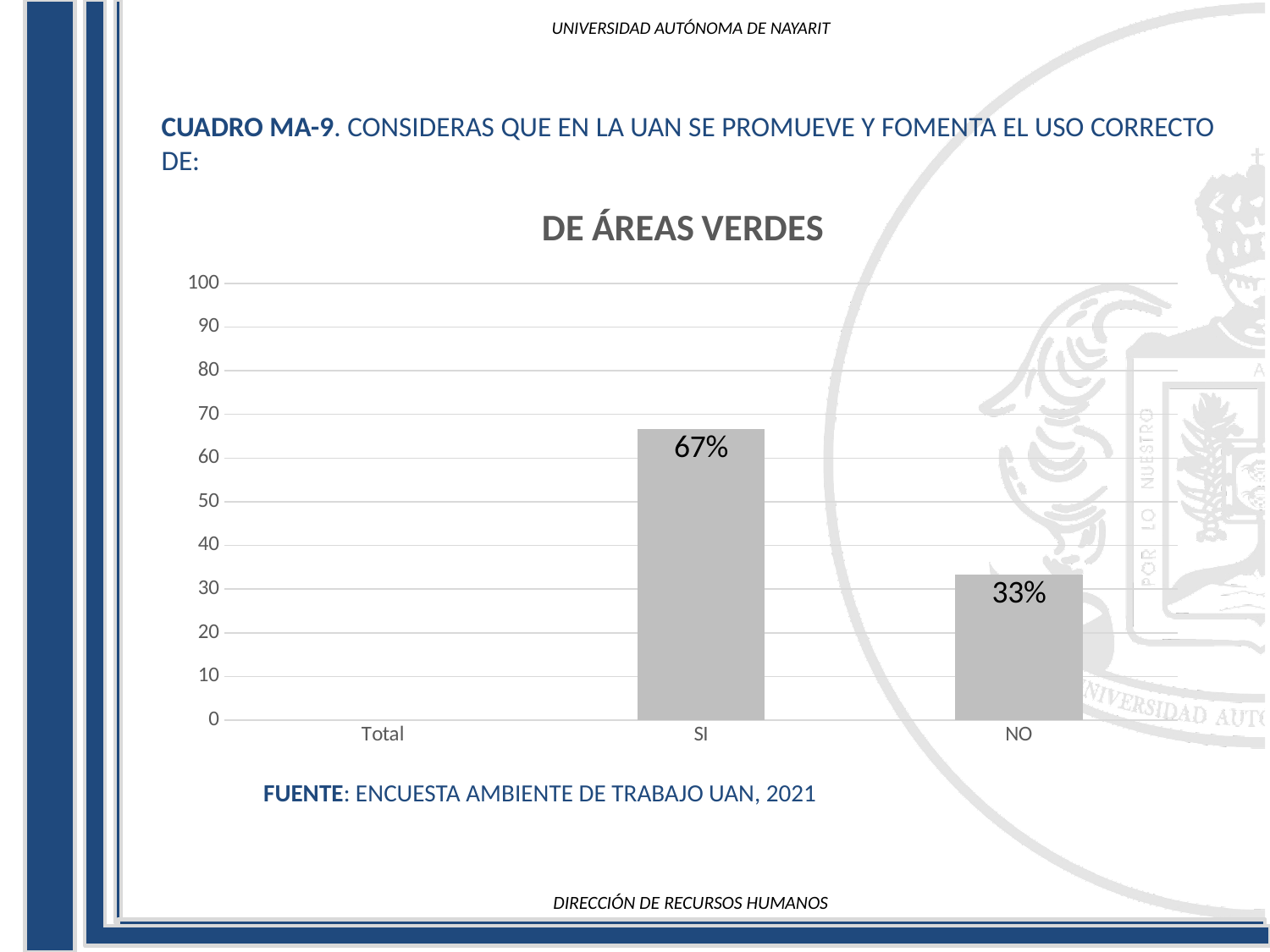
Is the value for SI greater or less than 60? greater How many categories are shown on the x axis? 3 What is the difference between the values for SI and NO? 34% Which is larger, the value for SI or the value for NO? SI What is the value for NO? 33% What kind of chart is shown? bar chart Is the value for NO greater or less than 40? less What is the maximum value shown on the y axis? 100 Which category has the lowest value among those with a visible bar? NO Which category has the highest value? SI What is the title of the chart? DE ÁREAS VERDES What is the value for SI? 67%